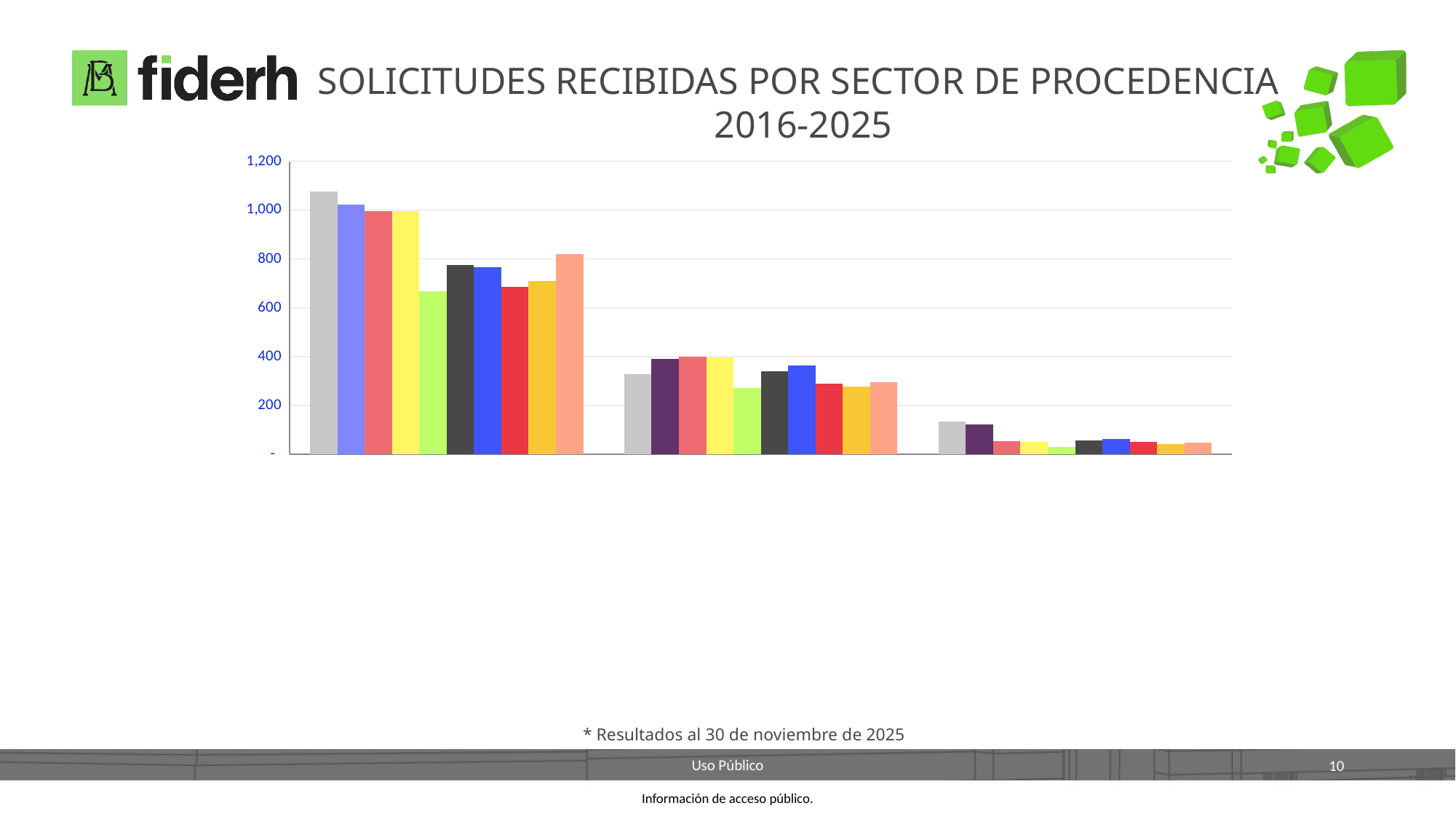
How many groups of bars does the chart show? 3 Is the tallest bar in the rightmost group greater or less than 200? less Is the tallest bar in the middle group greater or less than 600? less Which group of bars has the lowest values: the leftmost, middle, or rightmost? rightmost Is the tallest bar in the leftmost group greater or less than 1,000? greater Which group of bars has the highest values: the leftmost, middle, or rightmost? leftmost Is the first (grey) bar in the leftmost group taller or shorter than the first (grey) bar in the middle group? taller How many bars are in each group of the chart? 10 Do the values of the tallest bars in each group rise or fall from the leftmost group to the rightmost group? fall What kind of chart is shown on the slide? bar chart What is the highest value shown on the vertical axis of the chart? 1,200 What is the title of the chart on the slide? SOLICITUDES RECIBIDAS POR SECTOR DE PROCEDENCIA 2016-2025